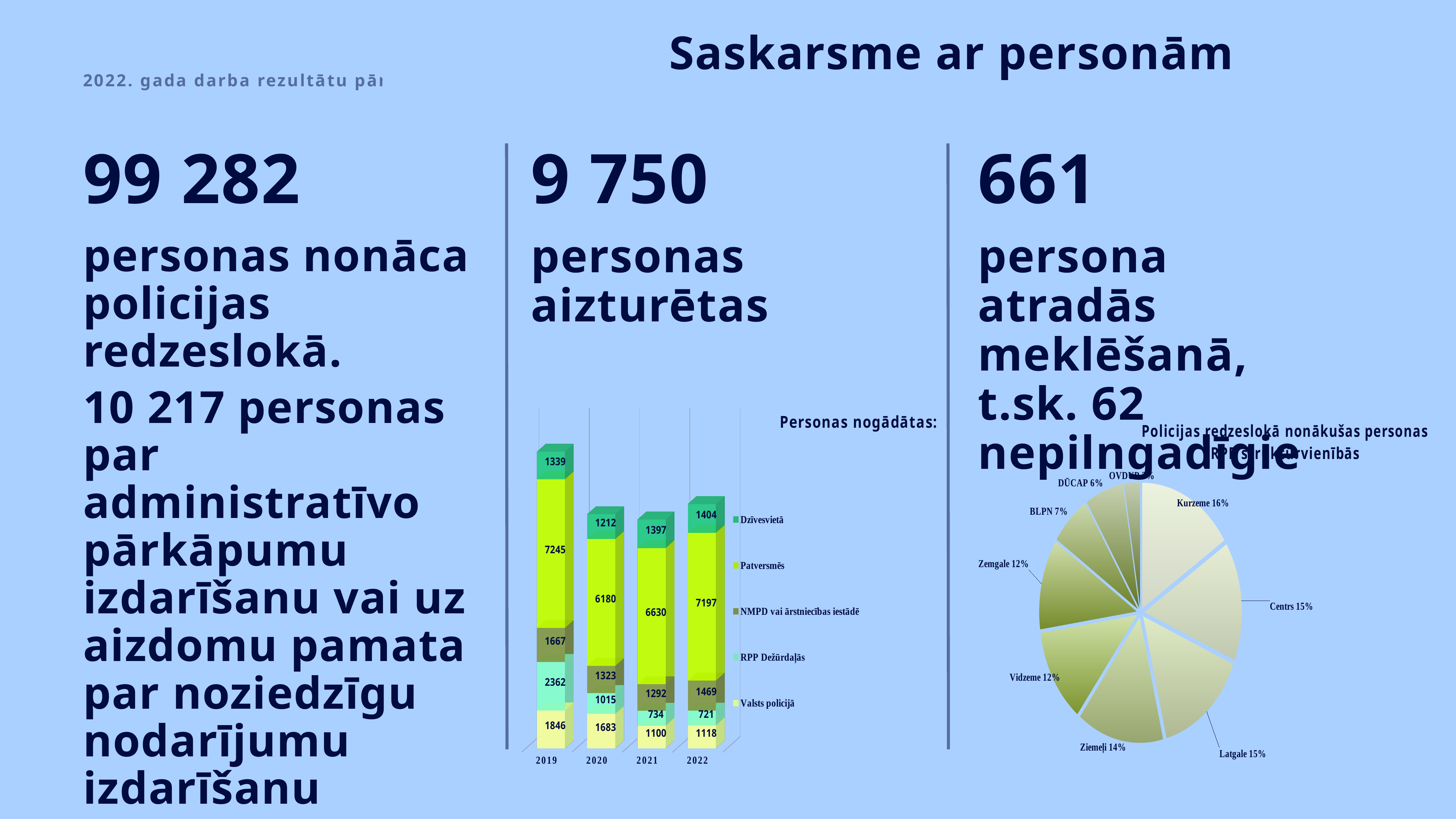
In the 'Personas nogādātas:' bar chart, which is larger: NMPD vai ārstniecības iestādē in 2020 or in 2022? 2022 What kind of chart is 'Personas nogādātas:'? Stacked bar chart In the pie chart 'Policijas redzeslokā nonākušas personas RPP struktūrvienībās', which slice is the largest? Kurzeme In the 'Personas nogādātas:' bar chart, what is the total of the stacked bar for 2020? 11413 In the 'Personas nogādātas:' bar chart, what is the value for Patversmēs in 2022? 7197 In the 'Personas nogādātas:' bar chart, which year has the lowest value for RPP Dežūrdaļās? 2022 In the pie chart 'Policijas redzeslokā nonākušas personas RPP struktūrvienībās', what share does Kurzeme have? 16% In the 'Personas nogādātas:' bar chart, what is the value for Valsts policijā in 2019? 1846 In the 'Personas nogādātas:' bar chart, which year has the highest value for Patversmēs? 2019 How many series does the legend of the 'Personas nogādātas:' bar chart list? 5 In the 'Personas nogādātas:' bar chart, what is the difference between the Dzīvesvietā values for 2022 and 2021? 7 In the 'Personas nogādātas:' bar chart, what is the value for RPP Dežūrdaļās in 2021? 734